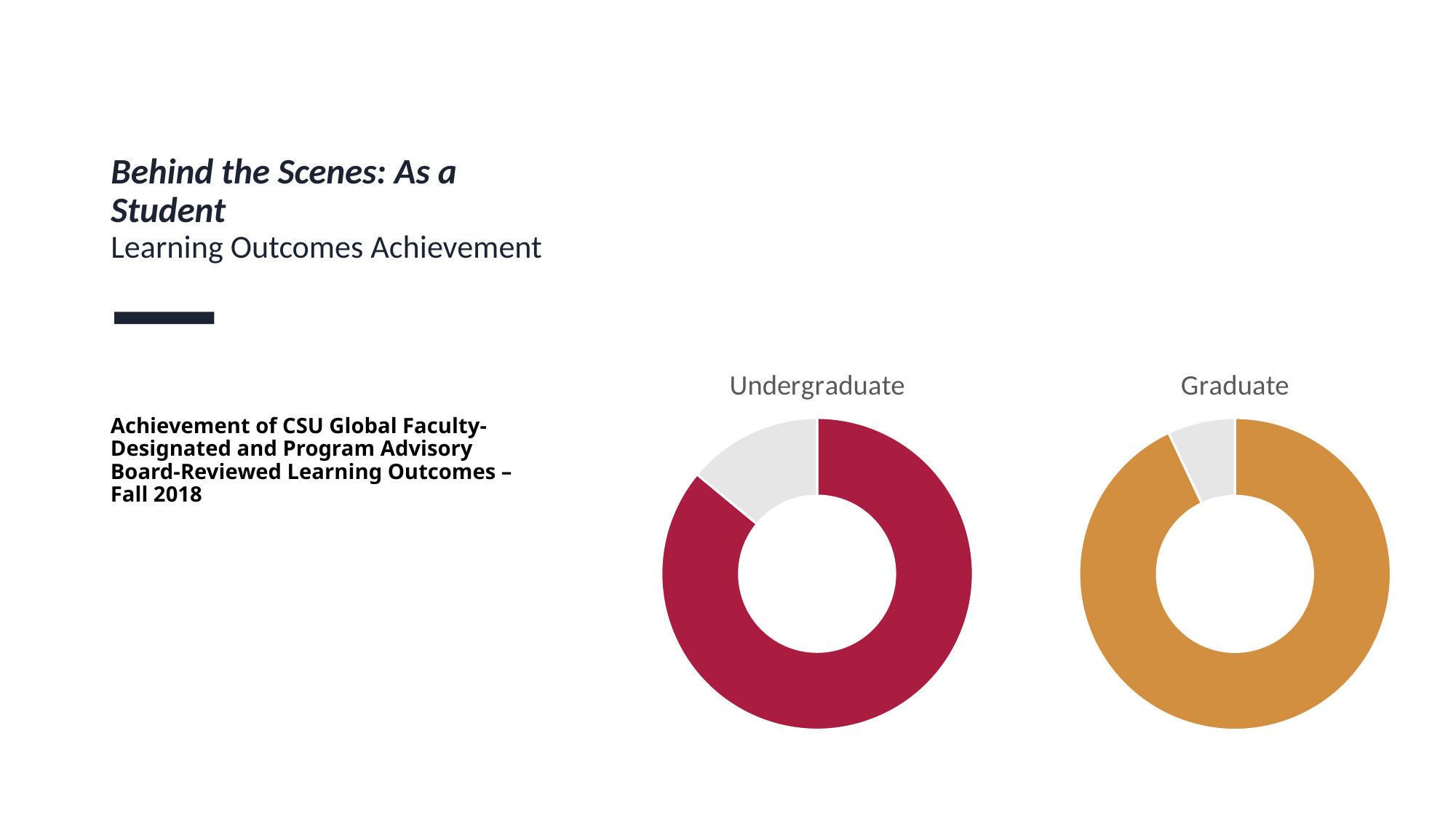
How many charts are shown on the slide? 2 What is the title of the chart on the right? Graduate What colour is the large slice in the Undergraduate chart? red Comparing the two charts, which one has the larger grey slice, Undergraduate or Graduate? Undergraduate How many slices does the Undergraduate doughnut chart have? 2 Comparing the two charts, which one has the larger coloured (non-grey) slice, Undergraduate or Graduate? Graduate In the Graduate chart, which slice is larger, the orange slice or the grey slice? the orange slice How many slices does the Graduate doughnut chart have? 2 What kind of chart is the Undergraduate chart? doughnut chart